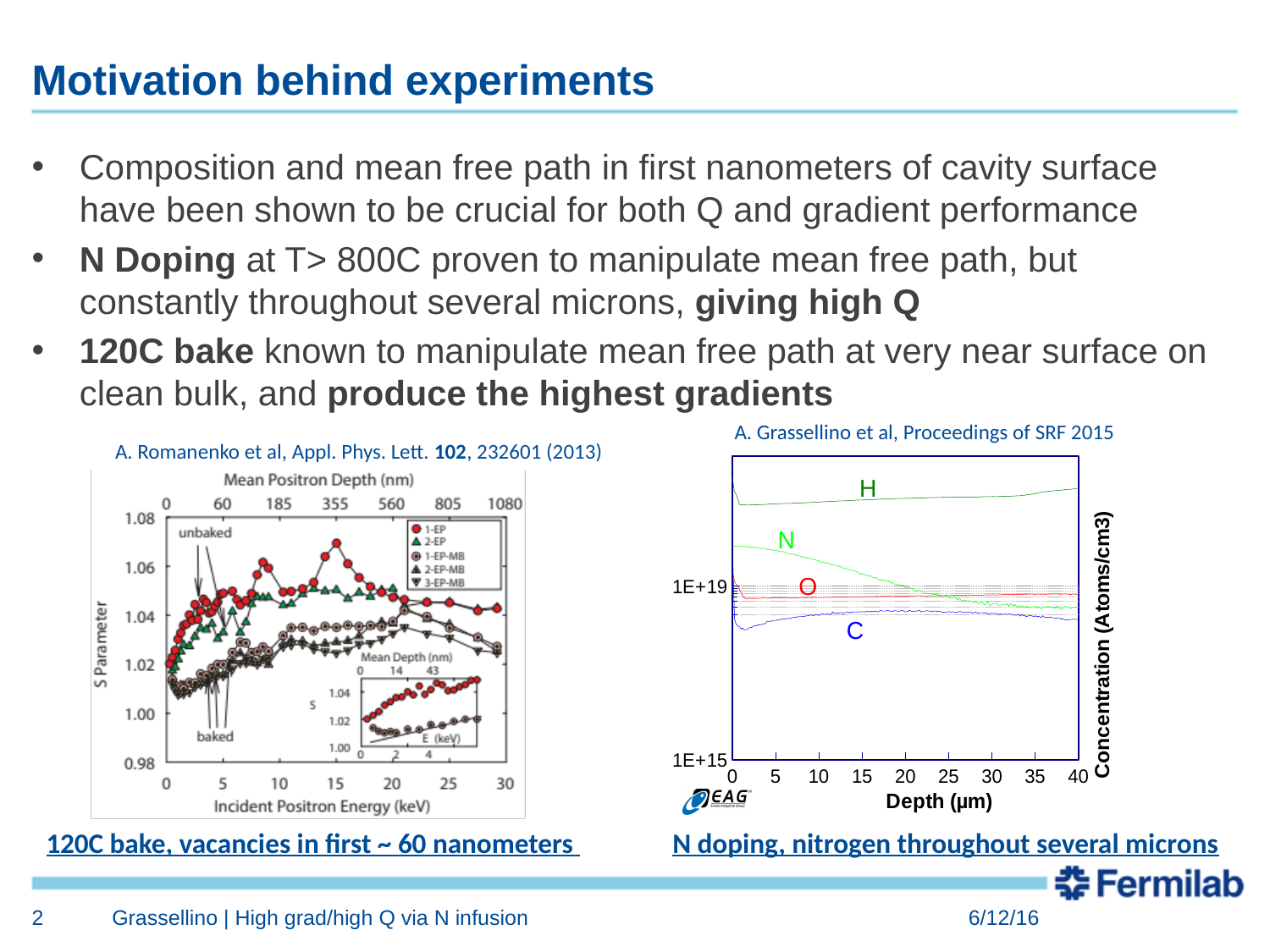
What is the y-axis label of the left-hand chart (S Parameter vs Incident Positron Energy)? S Parameter How many series does the legend of the left-hand chart (S Parameter vs Incident Positron Energy) list? 5 In the right-hand chart (Concentration vs Depth), is the C concentration at a depth of 10 μm greater or less than 1E+19? less In the right-hand chart (Concentration vs Depth), which is larger at a depth of 20 μm, the H concentration or the C concentration? H What kind of chart is the right-hand chart (Concentration vs Depth)? line chart In the right-hand chart (Concentration vs Depth), does the N concentration rise or fall as depth increases? fall In the right-hand chart (Concentration vs Depth), is the N concentration at a depth of 5 μm greater or less than 1E+19? greater In the right-hand chart (Concentration vs Depth), how many element curves are labelled? 4 In the left-hand chart (S Parameter vs Incident Positron Energy), which samples show the higher S parameter at low positron energy, the unbaked or the baked ones? unbaked In the right-hand chart (Concentration vs Depth), which element has the highest concentration across the depth range? H In the right-hand chart (Concentration vs Depth), which element has the lowest concentration across the depth range? C What is the x-axis label of the right-hand chart (Concentration vs Depth)? Depth (μm)